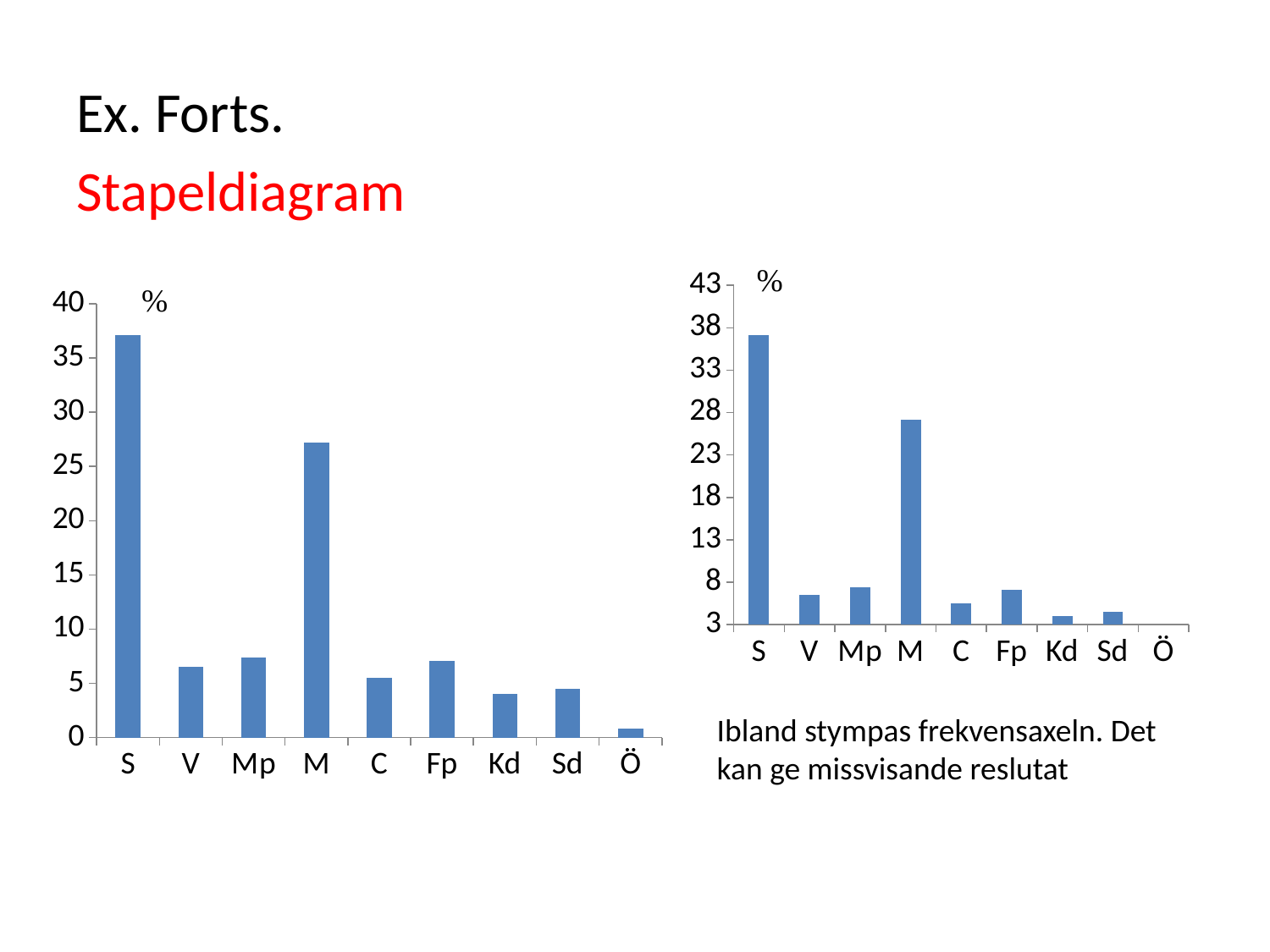
What kind of chart is the chart on the right? bar chart In the left chart, is the value for S greater or less than 35? greater In the left chart, is the value for Kd greater or less than 5? less In the left chart, how many categories are shown on the x axis? 9 In the right chart, which is larger, the value for Mp or the value for Kd? Mp In the left chart, which is larger, the value for M or the value for V? M In the left chart, is the value for M greater or less than 25? greater In the right chart, what is the lowest value shown on the vertical axis? 3 In the left chart, which category has the highest value? S In the left chart, which category has the lowest value? Ö In the right chart, which category has the highest value? S